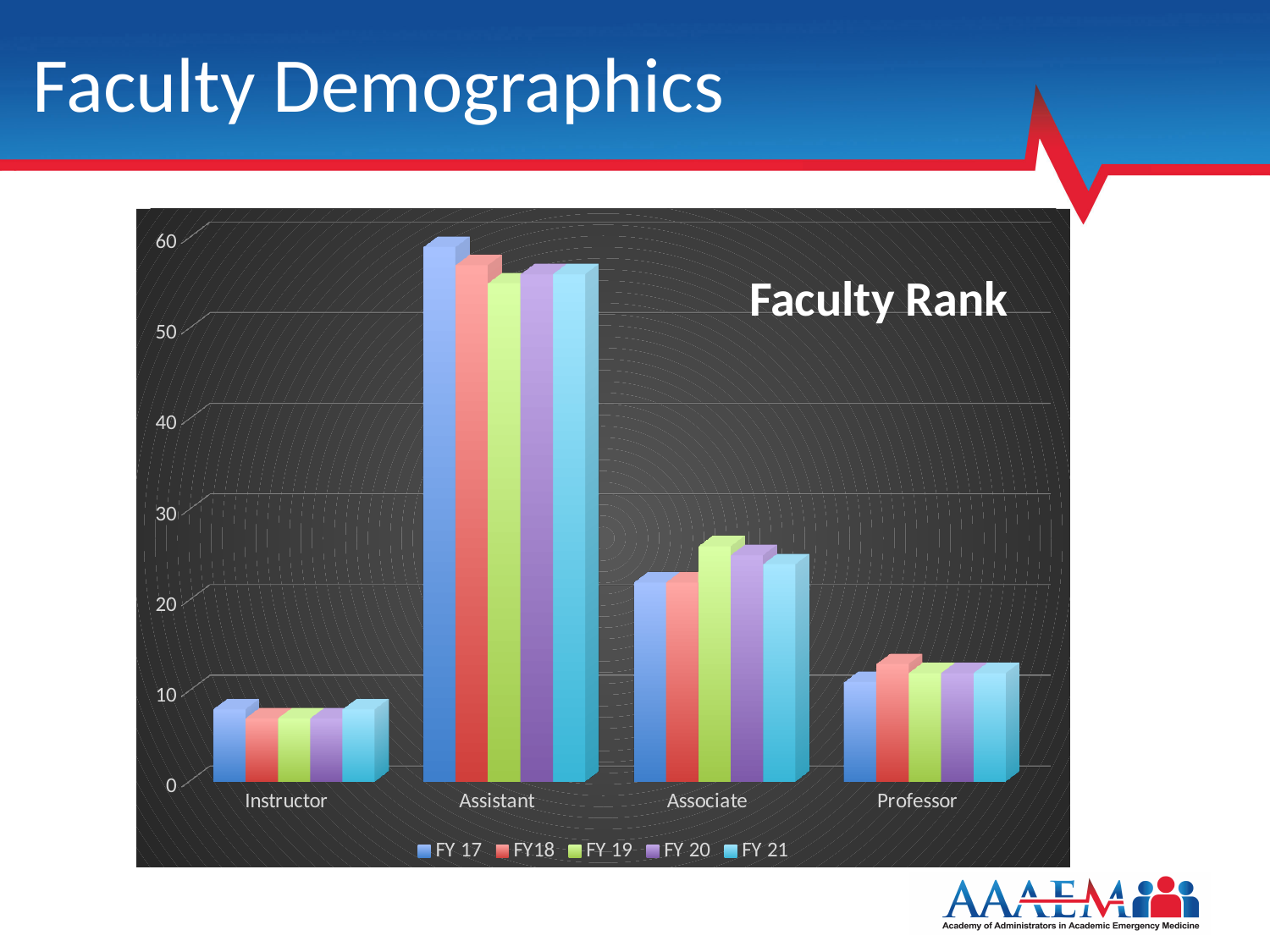
How many series does the chart's legend list? 5 How many categories are shown on the x axis of the chart? 4 Is the FY 21 value for Professor greater or less than 20? less Is the FY 17 value for Assistant greater or less than 50? greater What is the title of the chart? Faculty Rank Which faculty rank category has the highest values in the chart? Assistant What kind of chart is shown on the slide? bar chart Is the FY 19 value for Associate greater or less than 20? greater Which series is listed first in the chart's legend? FY 17 Which faculty rank category has the lowest values in the chart? Instructor Which is larger, the FY 20 value for Associate or the FY 20 value for Professor? Associate